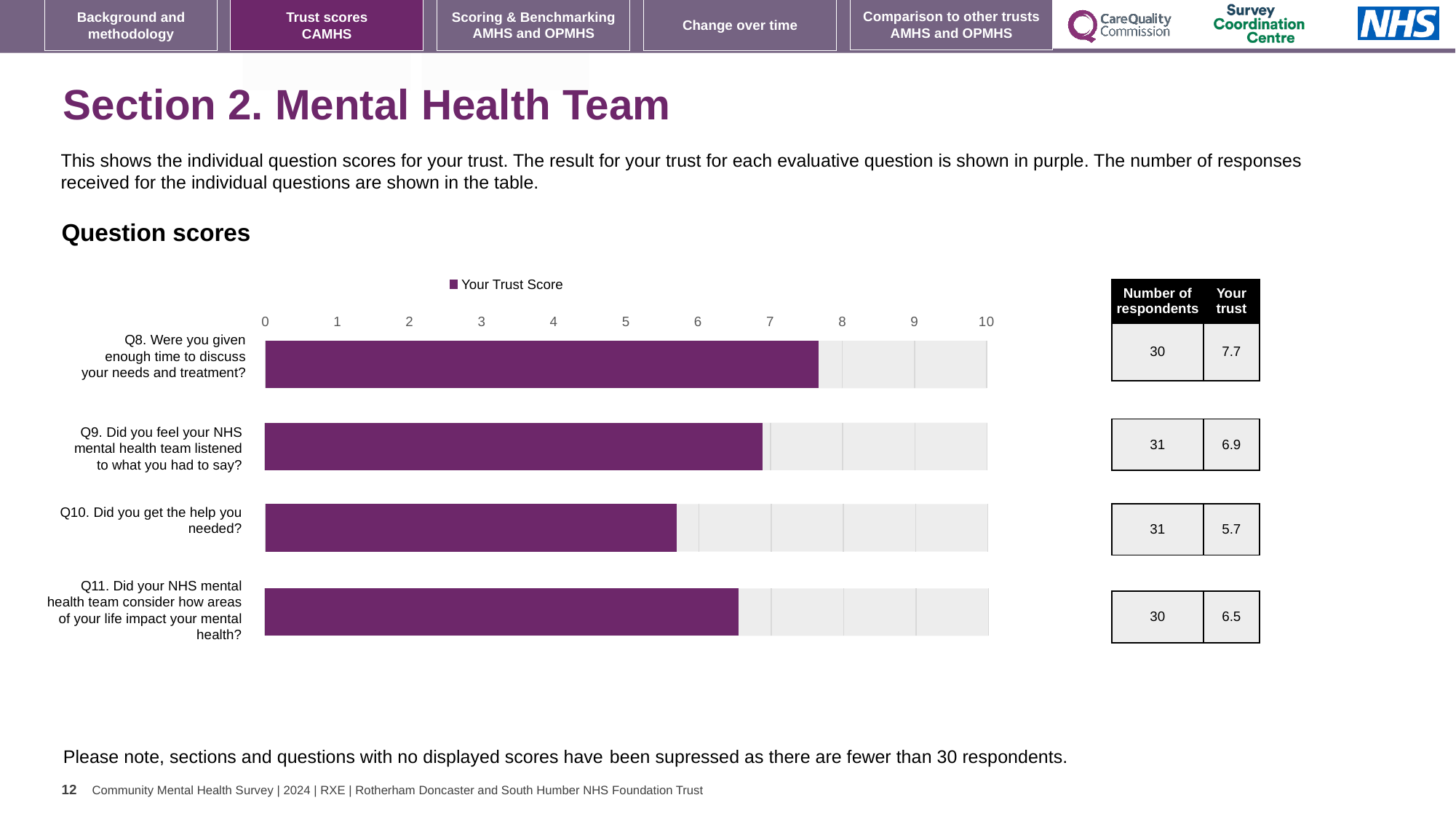
Which has the larger trust score, Q9 or Q11? Q9 What is the difference between the trust scores for Q8 and Q10? 2.0 What is the trust score for Q11 (Did your NHS mental health team consider how areas of your life impact your mental health?)? 6.5 Which question has the lowest trust score in the Question scores chart? Q10 Which question has the highest trust score in the Question scores chart? Q8 What is the trust score for Q10 (Did you get the help you needed?)? 5.7 What is the trust score for Q8 (Were you given enough time to discuss your needs and treatment?)? 7.7 How many questions are plotted in the Question scores chart? 4 How many series does the legend of the Question scores chart list? 1 What kind of chart is shown under "Question scores"? bar chart Is the trust score for Q10 greater or less than 6? less What is the name of the series shown in the legend of the Question scores chart? Your Trust Score